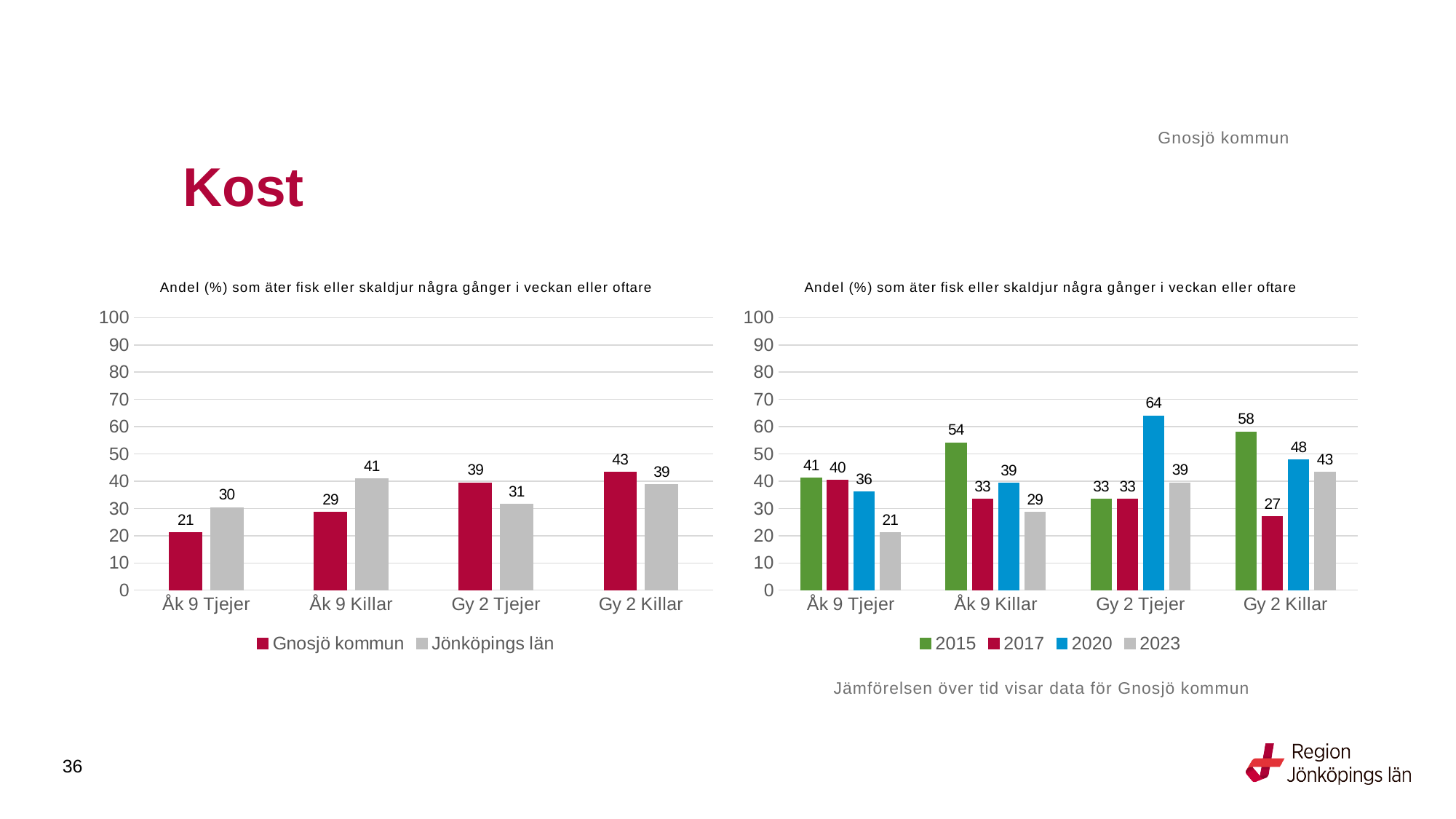
In the left chart, which category has the highest value for Gnosjö kommun? Gy 2 Killar In the left chart, what is the difference between Gnosjö kommun and Jönköpings län for Åk 9 Killar? 12 In the left chart, what is the value for Gnosjö kommun for Åk 9 Tjejer? 21 In the left chart, how many series does the legend list? 2 In the right chart, which year has the lowest value for Gy 2 Killar? 2017 In the right chart, what is the value for 2023 for Åk 9 Tjejer? 21 In the right chart, what is the difference between the 2015 and 2023 values for Åk 9 Killar? 25 In the right chart, what is the value for 2020 for Gy 2 Tjejer? 64 What kind of chart is the right chart? Bar chart In the left chart, what is the value for Jönköpings län for Åk 9 Killar? 41 In the left chart, which is larger for Gy 2 Tjejer: Gnosjö kommun or Jönköpings län? Gnosjö kommun In the right chart, how many series does the legend list? 4